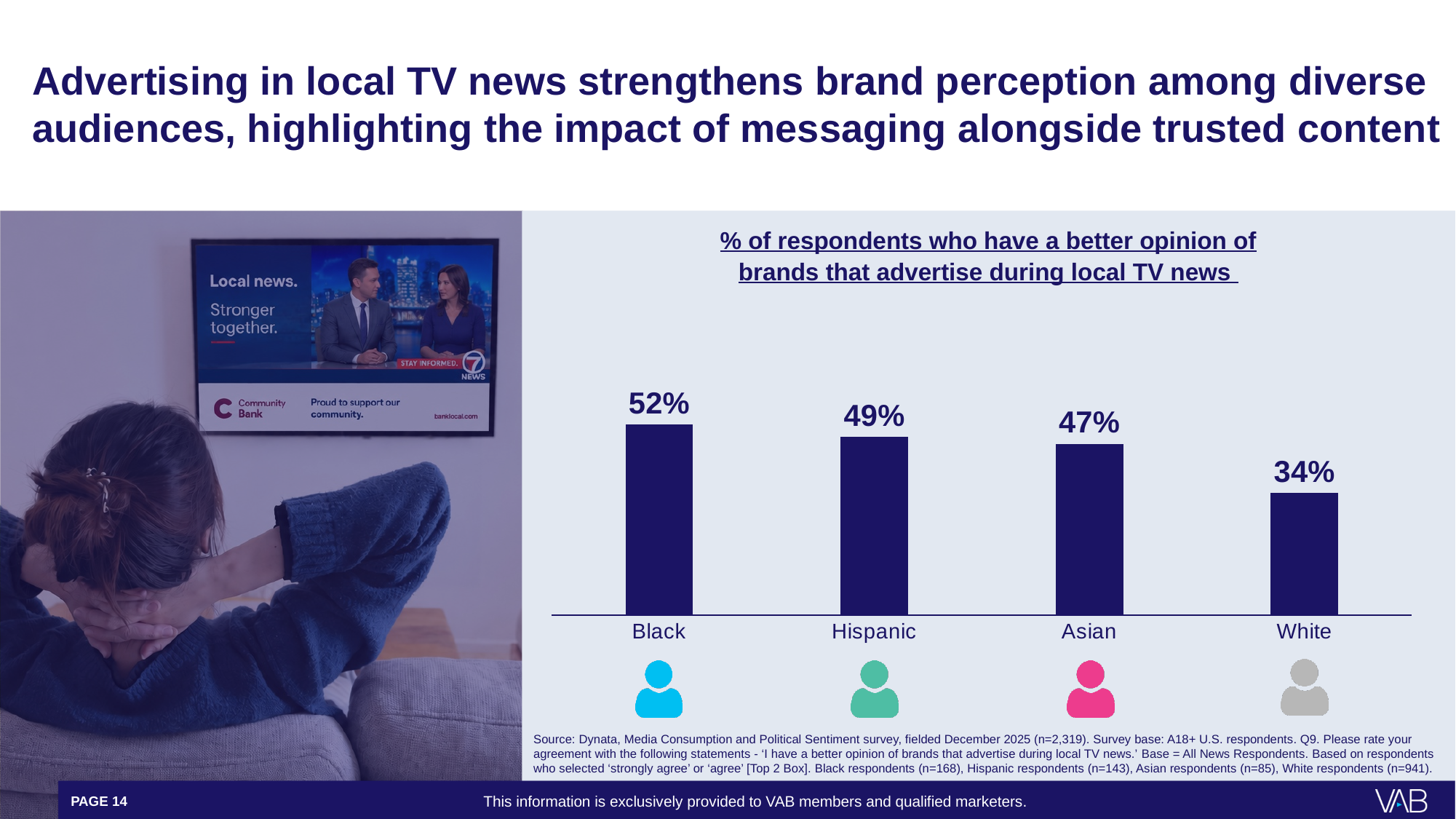
What is the difference in percentage points between Black and White respondents? 18 What is the value shown for Asian respondents? 47% Which group has the lowest percentage in the chart? White What is the value shown for Hispanic respondents? 49% How many groups are shown in the chart? 4 Do the values rise or fall moving from left to right across the chart? Fall What is the value shown for White respondents? 34% What is the difference in percentage points between Hispanic and Asian respondents? 2 Which group has the highest percentage of respondents with a better opinion of brands that advertise during local TV news? Black What kind of chart is shown on the slide? Bar chart What percentage of Black respondents have a better opinion of brands that advertise during local TV news? 52% Which is larger, the value for Hispanic respondents or the value for White respondents? Hispanic